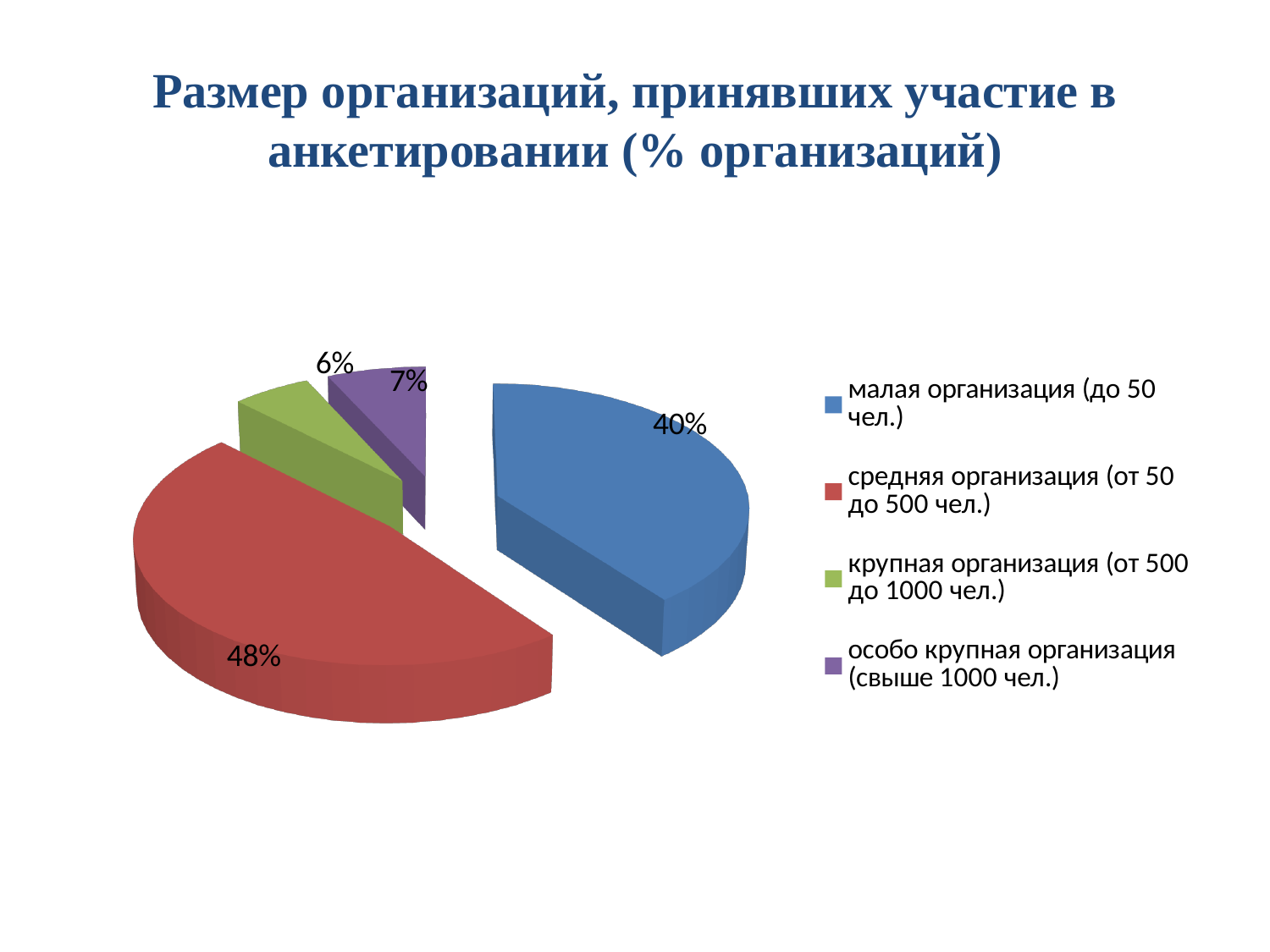
Which category has the largest share of the pie? средняя организация (от 50 до 500 чел.) Which is larger: the share of small organisations or the share of medium organisations? средняя организация (от 50 до 500 чел.) Which category has the smallest share of the pie? крупная организация (от 500 до 1000 чел.) What percentage is shown for large organisations (крупная организация, от 500 до 1000 чел.)? 6% What percentage is shown for especially large organisations (особо крупная организация, свыше 1000 чел.)? 7% What type of chart is shown on the slide? pie chart What colour is the slice for small organisations (малая организация)? blue What is the difference in percentage points between especially large organisations (7%) and large organisations (6%)? 1 How many slices does the pie chart have? 4 What share of the pie is taken by medium organisations (средняя организация, от 50 до 500 чел.)? 48% What is the difference in percentage points between medium organisations (48%) and small organisations (40%)? 8 What percentage of organisations are small organisations (малая организация, до 50 чел.)? 40%